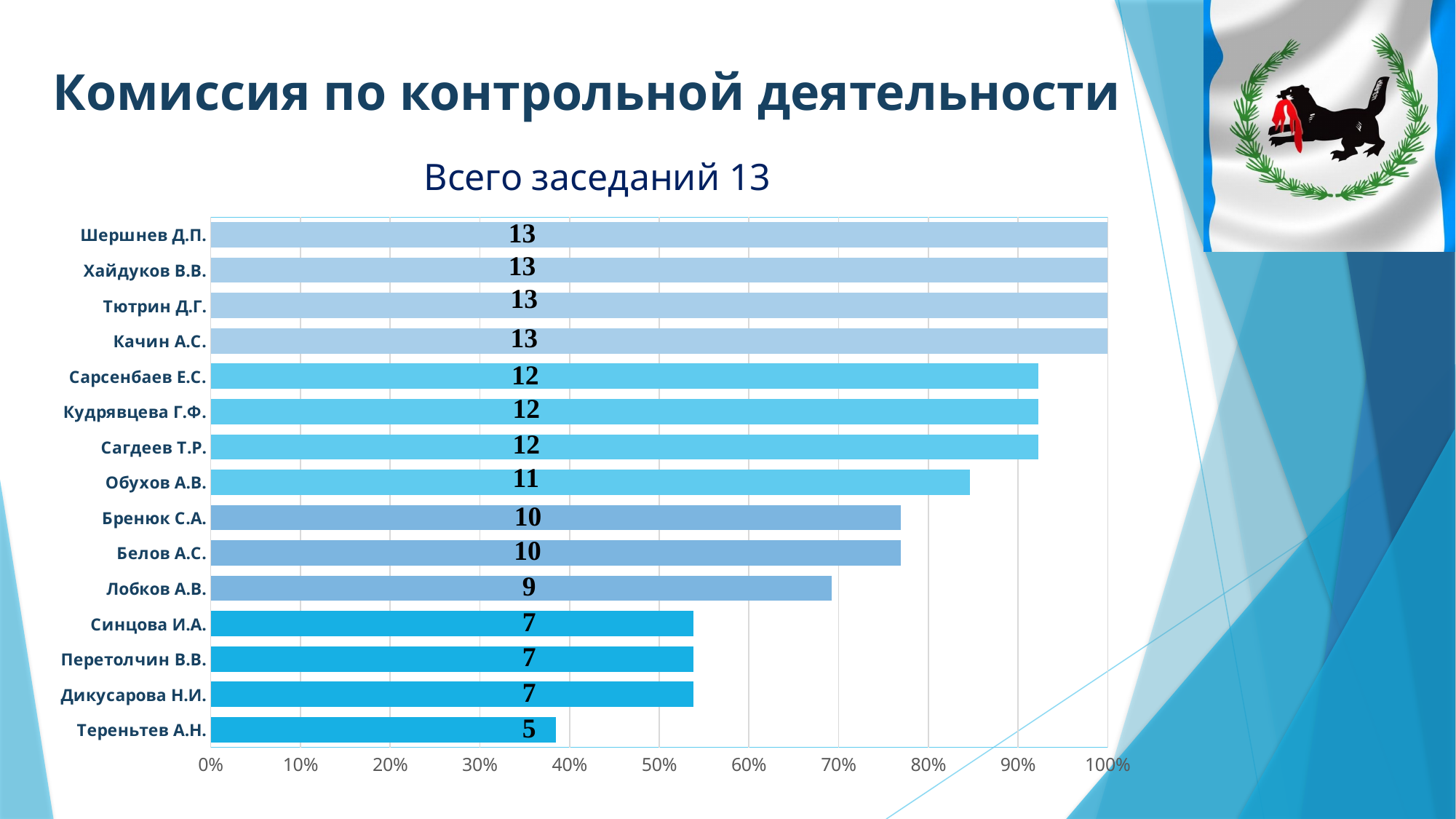
What is the data label value for Сагдеев Т.Р.? 12 What is the data label value for Тереньтев А.Н.? 5 Which person has the lowest value in the chart? Тереньтев А.Н. Is the bar for Обухов А.В. greater or less than 80% on the x axis? greater Is the bar for Тереньтев А.Н. greater or less than 40% on the x axis? less What is the difference between the values for Шершнев Д.П. and Тереньтев А.Н.? 8 What is the data label value for Лобков А.В.? 9 What kind of chart is shown on the slide? bar chart Which value is larger: Обухов А.В. or Лобков А.В.? Обухов А.В. What is the chart's title? Всего заседаний 13 How many people (categories) are listed in the chart? 15 What is the data label value for Обухов А.В.? 11